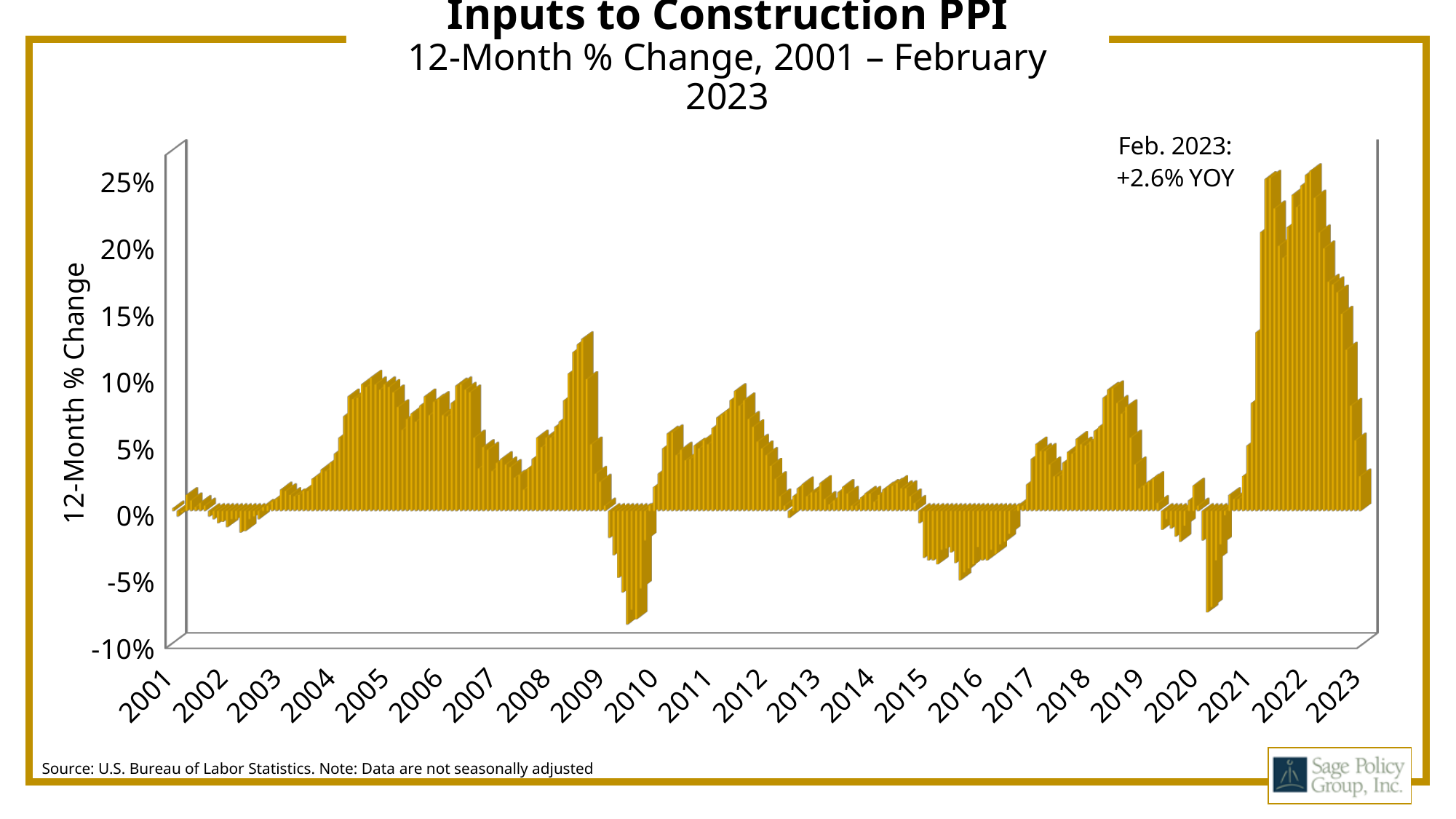
How many year labels are shown on the x axis? 23 Which is larger: the peak around 2008 or the peak around 2021–2022? the peak around 2021–2022 From the peak in 2022 to February 2023, do the values rise or fall? fall Is the peak value reached around 2008 greater or less than 10%? greater What is the title of the y axis? 12-Month % Change Are the values during 2013 greater or less than 5%? less Which is lower: the trough around 2009 or the trough around 2015–2016? the trough around 2009 What is the 12-month % change for February 2023 according to the annotation on the chart? +2.6% YOY Is the lowest value reached on the chart (around 2009) greater or less than -5%? less What kind of chart is shown on the slide? bar chart What source is cited for the chart data? U.S. Bureau of Labor Statistics